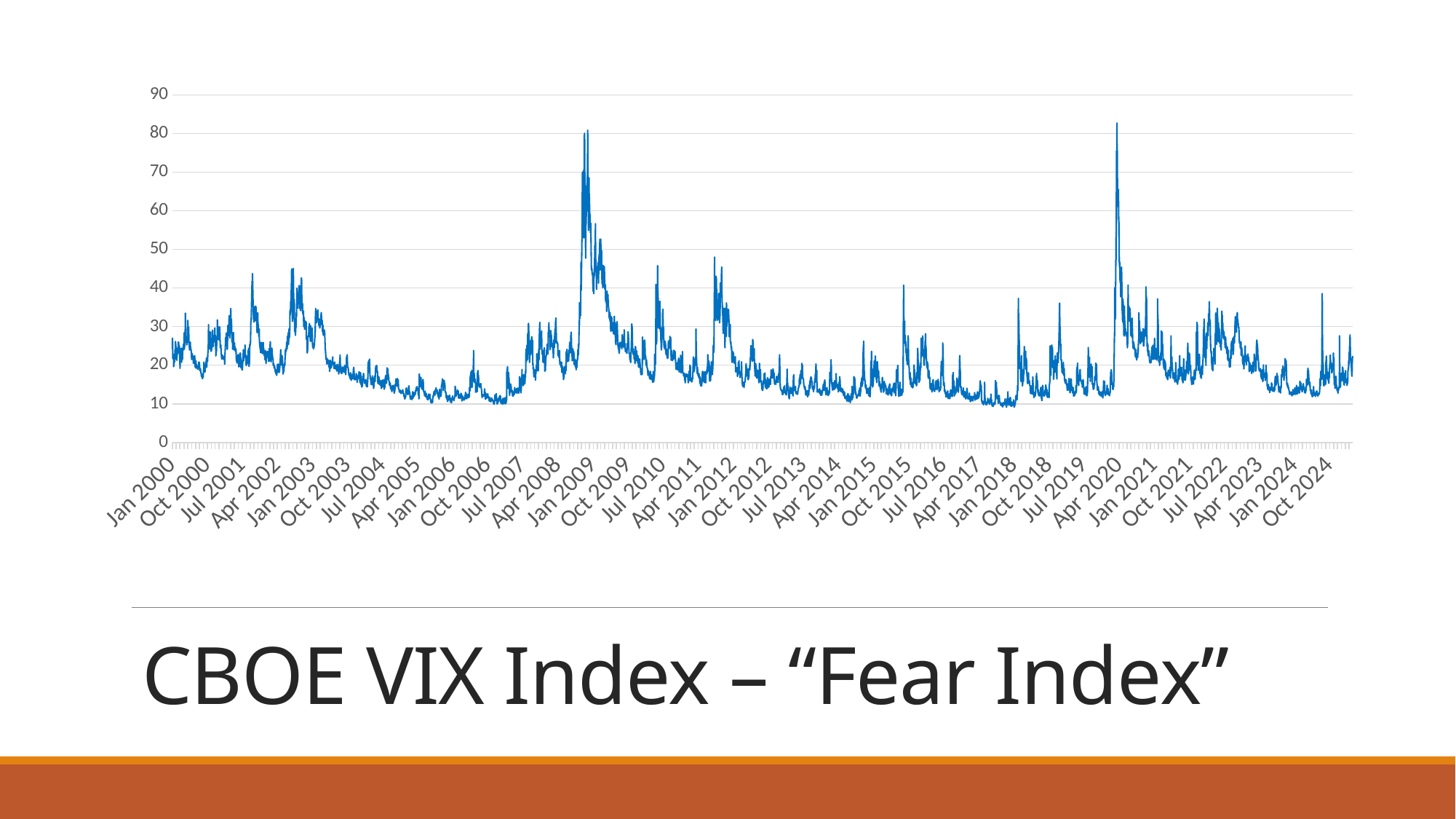
What is the last date label on the horizontal axis? Oct 2024 Is the value of the line around Jan 2007 greater or less than 20? less Is the peak value of the line around Oct 2011 greater or less than 40? greater What is the highest value shown on the vertical axis? 90 Is the peak value of the line around Jan 2015 greater or less than 50? less What is the title of the slide containing the chart? CBOE VIX Index – "Fear Index" What kind of chart is shown on the slide? line chart What is the first date label on the horizontal axis? Jan 2000